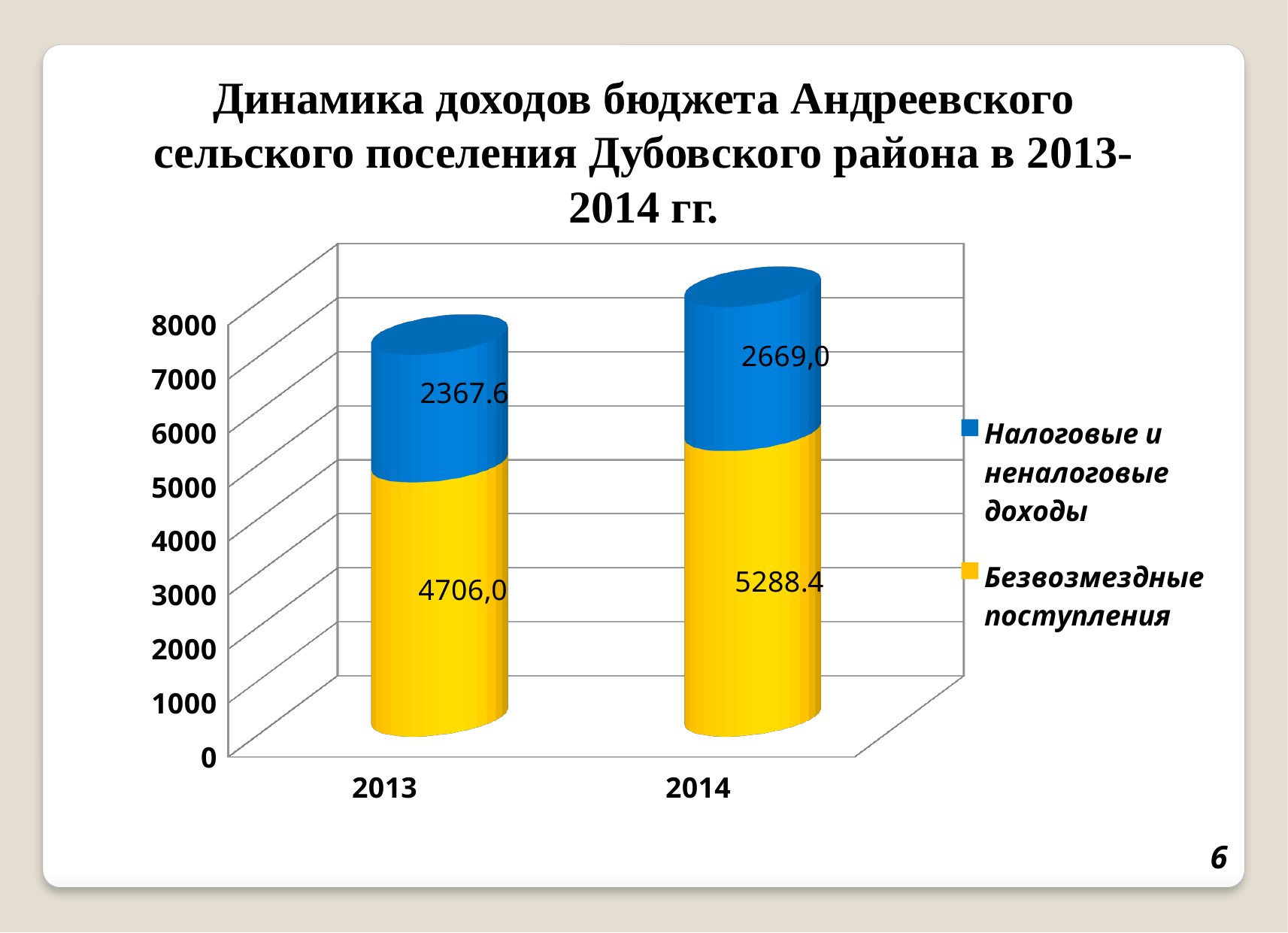
What is the value of Безвозмездные поступления for 2014? 5288.4 What is the value of Налоговые и неналоговые доходы for 2013? 2367.6 What is the total of the stacked bar for 2014? 7957.4 What is the value of Налоговые и неналоговые доходы for 2014? 2669,0 What is the total of the stacked bar for 2013? 7073.6 By how much did Налоговые и неналоговые доходы increase from 2013 to 2014? 301.4 How many series does the legend list? 2 What is the difference in Безвозмездные поступления between 2014 and 2013? 582.4 How many years are shown on the x axis? 2 Which series is shown in yellow? Безвозмездные поступления What is the value of Безвозмездные поступления for 2013? 4706,0 Which year has the higher value for Безвозмездные поступления? 2014